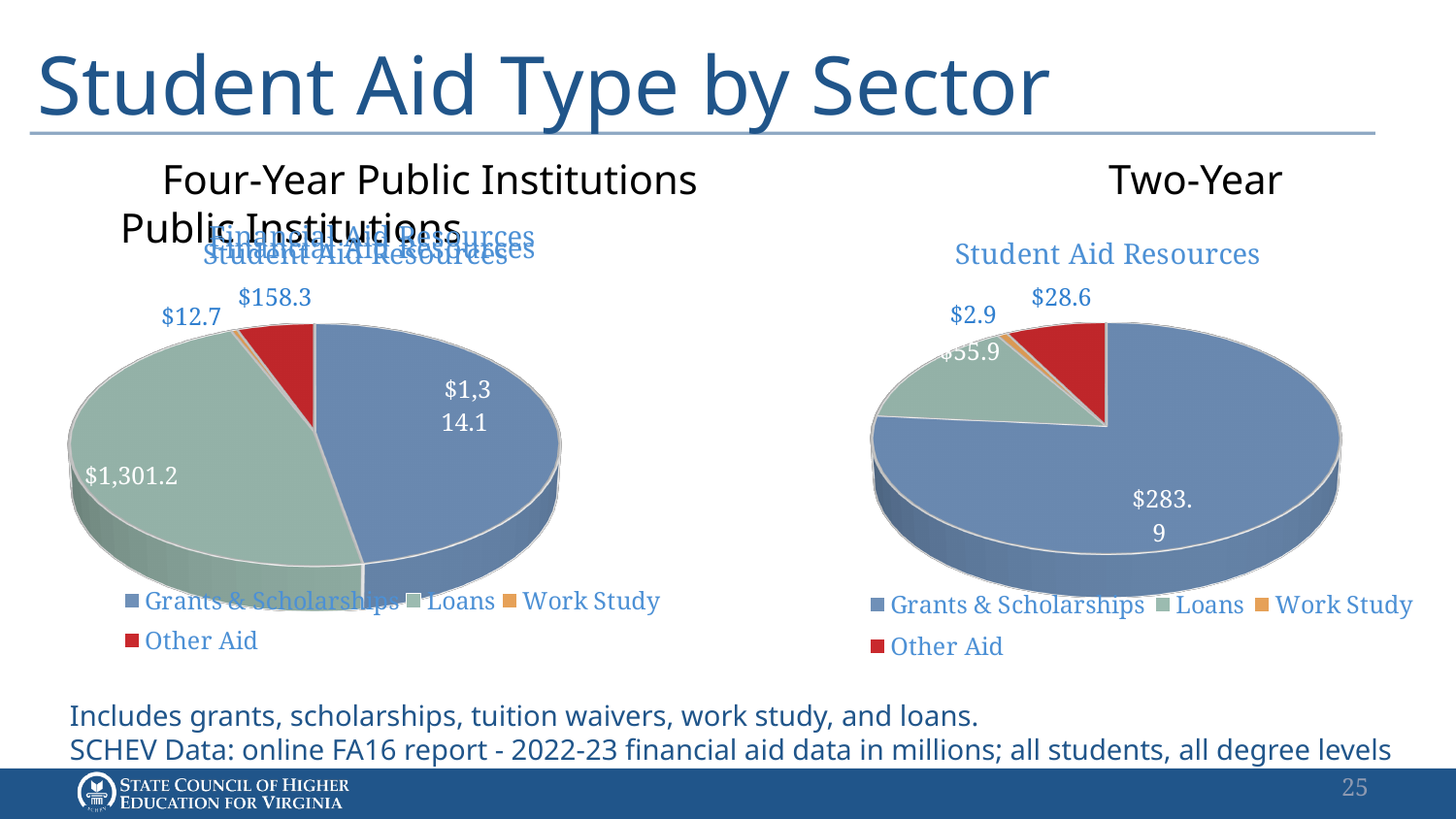
How many categories does the legend list for the Two-Year Public Institutions chart? 4 On the Two-Year Public Institutions chart, what is the value for Work Study? $2.9 What type of chart is used for the Four-Year Public Institutions data? Pie chart On the Four-Year Public Institutions chart, what is the value for Other Aid? $158.3 On the Two-Year Public Institutions chart, what is the value for Grants & Scholarships? $283.9 On the Four-Year Public Institutions chart, which category has the smallest slice? Work Study On the Four-Year Public Institutions chart, what is the value for Loans? $1,301.2 On the Four-Year Public Institutions chart, what is the difference between Other Aid and Work Study? $145.6 On the Four-Year Public Institutions chart, which is larger, Grants & Scholarships or Loans? Grants & Scholarships On the Two-Year Public Institutions chart, which category has the largest slice? Grants & Scholarships On the Four-Year Public Institutions chart, what is the value for Grants & Scholarships? $1,314.1 On the Two-Year Public Institutions chart, what is the difference between Grants & Scholarships and Other Aid? $255.3